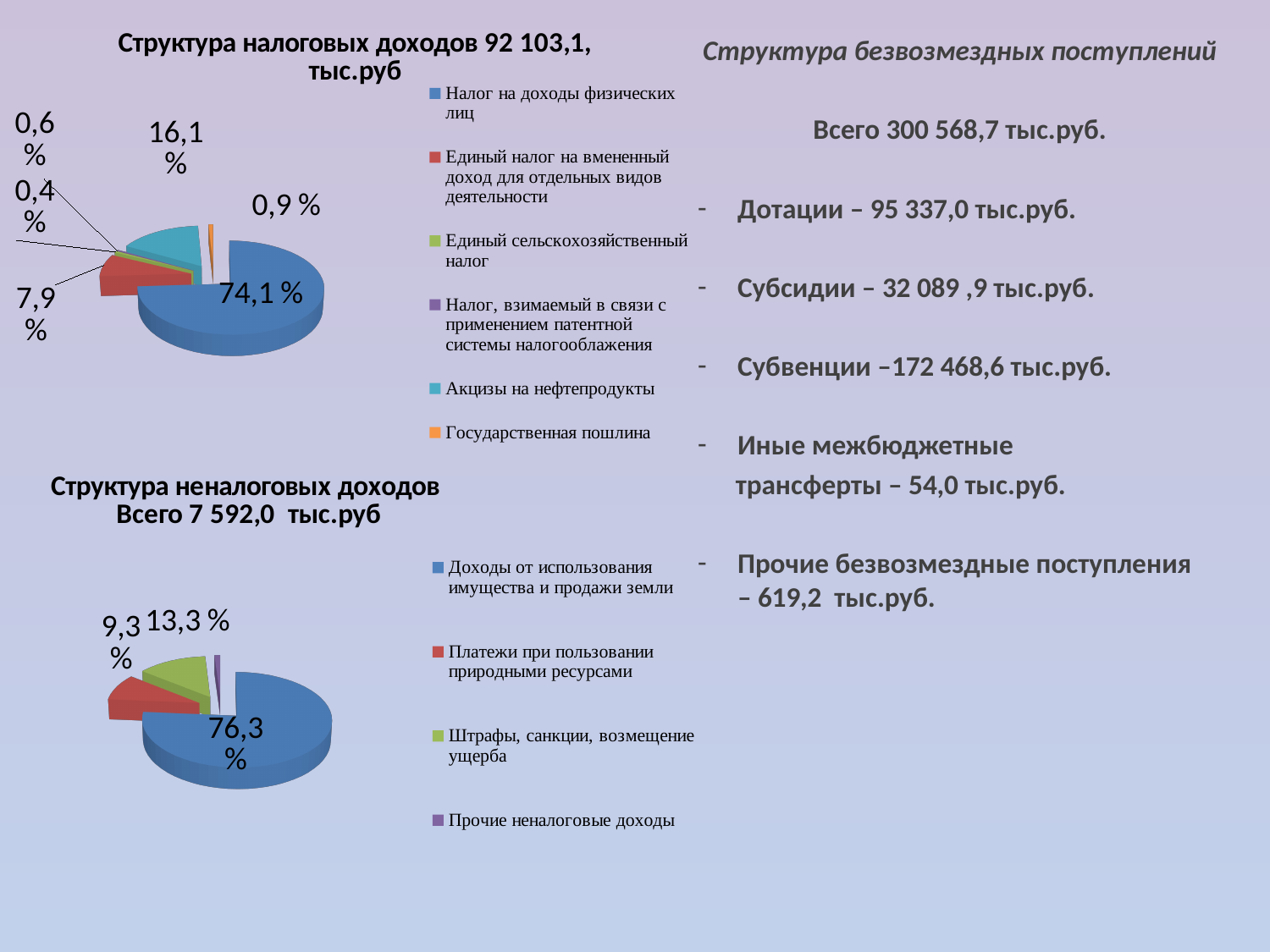
In the 'Структура налоговых доходов' chart, which category has the largest share? Налог на доходы физических лиц In the 'Структура неналоговых доходов' chart, which is larger: 'Штрафы, санкции, возмещение ущерба' or 'Платежи при пользовании природными ресурсами'? Штрафы, санкции, возмещение ущерба In the 'Структура налоговых доходов' chart, what share does 'Единый налог на вмененный доход для отдельных видов деятельности' have? 7,9 % In the 'Структура налоговых доходов' chart, what is the difference between the shares of 'Налог на доходы физических лиц' and 'Акцизы на нефтепродукты'? 58,0 % In the 'Структура налоговых доходов' chart, what share does 'Налог на доходы физических лиц' have? 74,1 % What kind of chart is the 'Структура налоговых доходов' chart? pie chart In the 'Структура налоговых доходов' chart, how many categories does the legend list? 6 In the 'Структура налоговых доходов' chart, what share does 'Акцизы на нефтепродукты' have? 16,1 % In the 'Структура неналоговых доходов' chart, what share does 'Доходы от использования имущества и продажи земли' have? 76,3 % In the 'Структура неналоговых доходов' chart, how many categories does the legend list? 4 What total amount is stated in the title of the 'Структура неналоговых доходов' chart? 7 592,0 тыс.руб In the 'Структура налоговых доходов' chart, what share does 'Государственная пошлина' have? 0,9 %